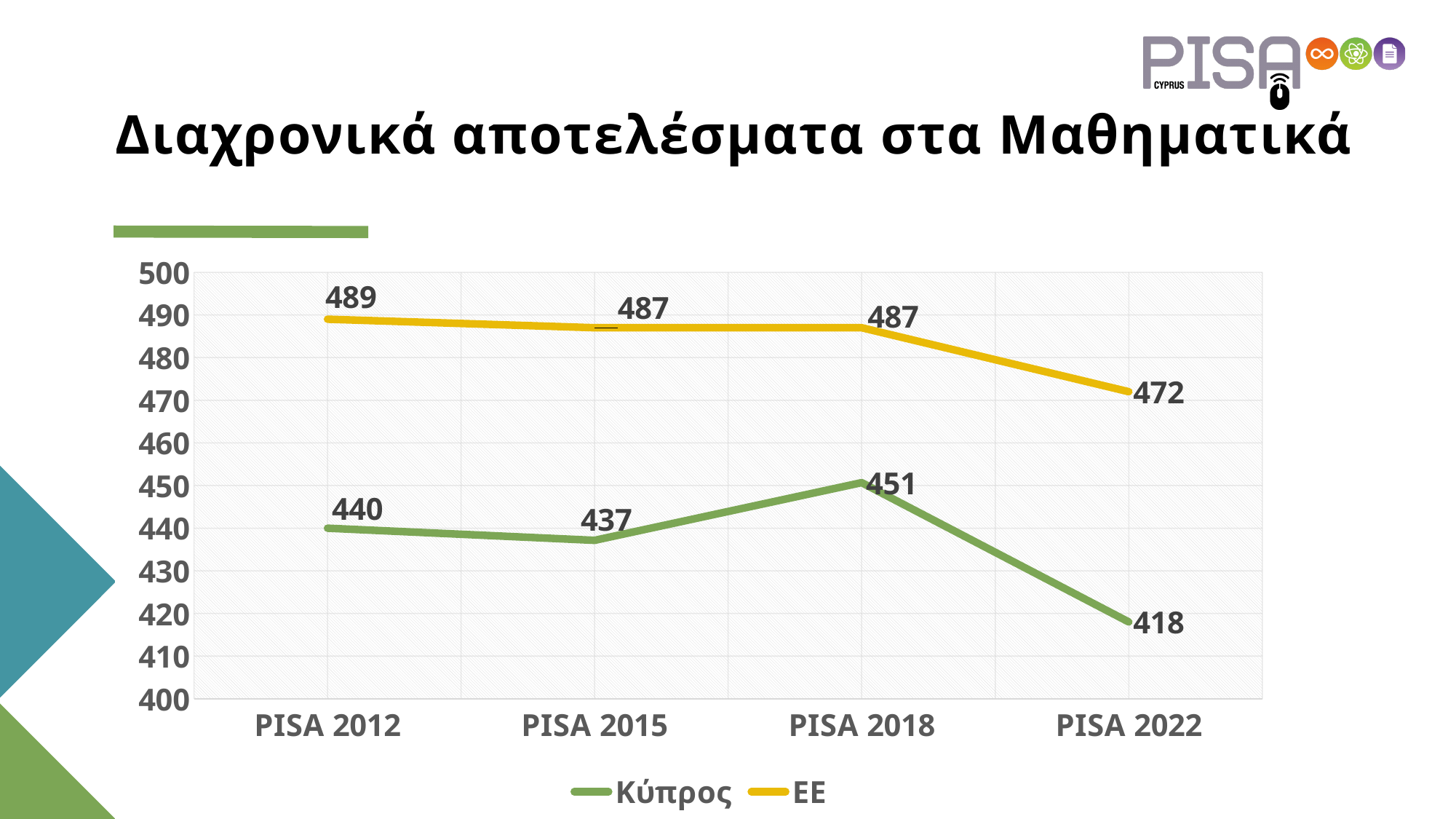
Which is larger at PISA 2015: the Κύπρος value or the ΕΕ value? ΕΕ At which PISA cycle is the ΕΕ value lowest? PISA 2022 What is the value for ΕΕ at PISA 2022? 472 How many series does the legend list? 2 Does the Κύπρος line rise or fall between PISA 2018 and PISA 2022? Fall How many PISA cycles are shown on the x axis? 4 At which PISA cycle is the Κύπρος value highest? PISA 2018 What is the difference between the Κύπρος values at PISA 2018 and PISA 2022? 33 What is the difference between the ΕΕ and Κύπρος values at PISA 2022? 54 What is the value for Κύπρος at PISA 2018? 451 What is the value for Κύπρος at PISA 2012? 440 What kind of chart is shown on the slide? Line chart